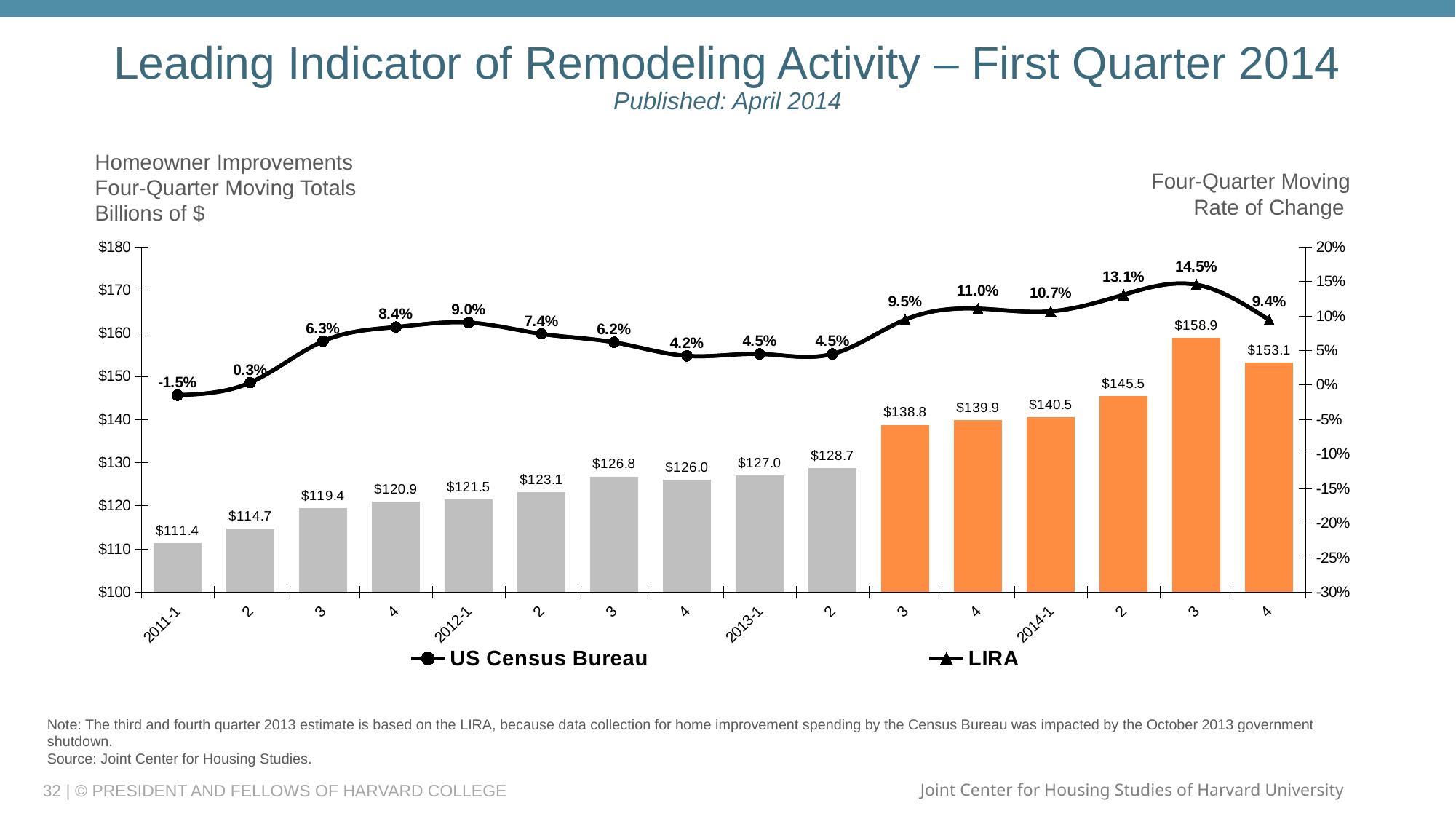
How many series does the legend list? 2 What is the four-quarter moving rate of change for 2014-3? 14.5% What is the difference between the four-quarter moving totals for 2014-3 and 2014-4? $5.8 Which quarter has the highest four-quarter moving total? 2014-3 Which quarter has the lowest four-quarter moving rate of change? 2011-1 What is the four-quarter moving total for 2013-2? $128.7 Which is larger, the four-quarter moving total for 2013-3 or for 2013-4? 2013-4 What is the four-quarter moving total for 2011-1? $111.4 What kind of chart is used for the four-quarter moving totals? bar chart How many quarters are shown on the x axis? 16 Is the four-quarter moving total for 2014-2 greater or less than $140? greater What are the two series named in the legend? US Census Bureau and LIRA